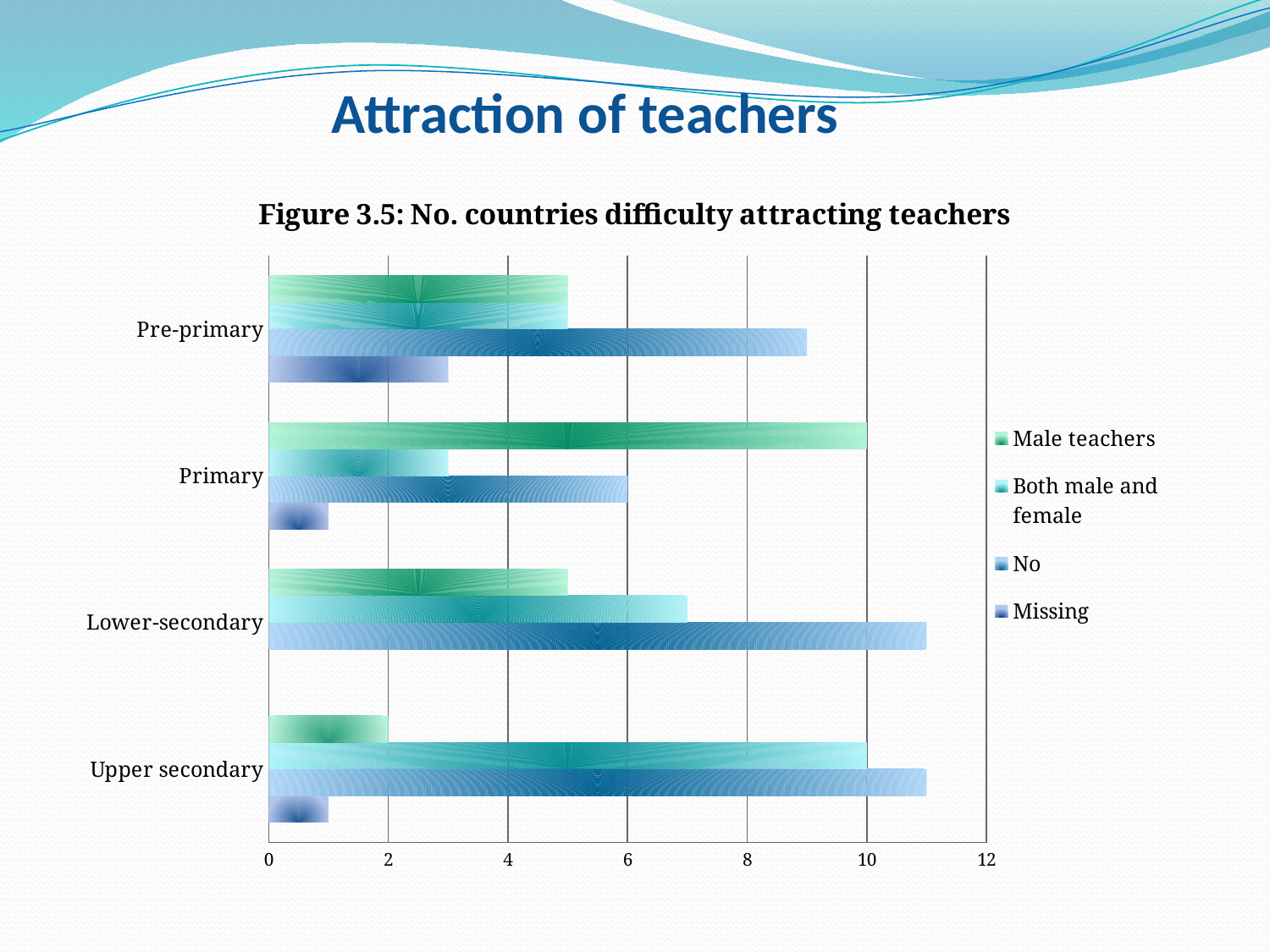
How many education-level categories are shown on the chart? 4 How many series does the legend list? 4 What is the value for No at the Primary level? 6 What is the value for Male teachers at the Upper secondary level? 2 What kind of chart is shown on the slide? bar chart Is the value for Missing at the Pre-primary level greater or less than 4? less What is the difference between the Male teachers value and the No value at the Primary level? 4 Is the value for No at the Pre-primary level greater or less than 8? greater What is the value for Both male and female at the Upper secondary level? 10 Which education level has the highest value for Male teachers? Primary What is the value for Male teachers at the Primary level? 10 Which is larger, the No value for Lower-secondary or the No value for Primary? Lower-secondary